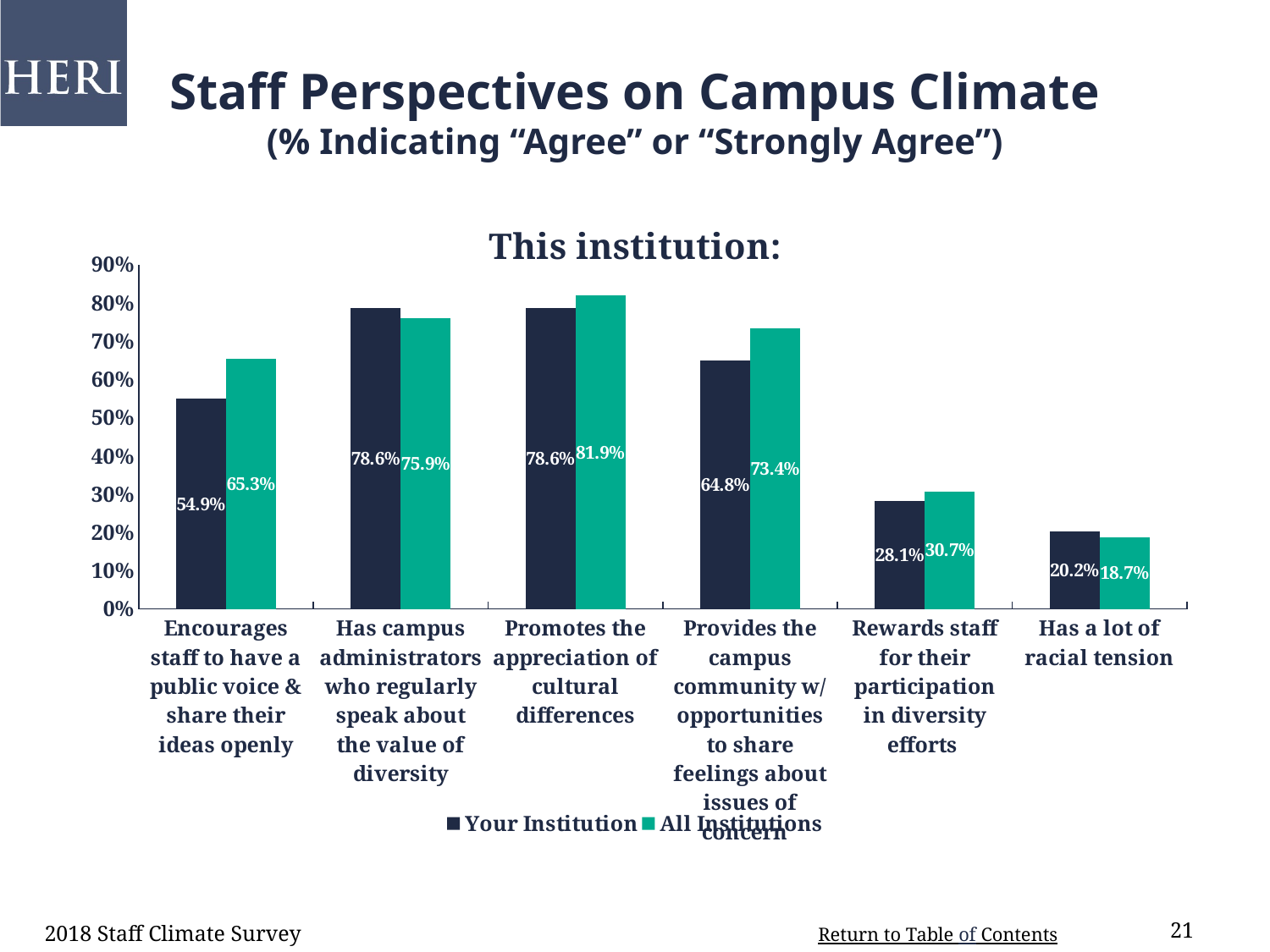
For "Has campus administrators who regularly speak about the value of diversity", which is larger: Your Institution or All Institutions? Your Institution What kind of chart is shown on the slide? bar chart How many categories are shown on the x axis? 6 What is the title of the chart? This institution: What is the value for All Institutions for "Promotes the appreciation of cultural differences"? 81.9% Which category has the lowest value for All Institutions? Has a lot of racial tension What is the difference between All Institutions and Your Institution for "Encourages staff to have a public voice & share their ideas openly"? 10.4% Which category has the highest value for All Institutions? Promotes the appreciation of cultural differences What is the value for Your Institution for "Encourages staff to have a public voice & share their ideas openly"? 54.9% How many series does the legend list? 2 What is the value for Your Institution for "Rewards staff for their participation in diversity efforts"? 28.1% Is the value for Your Institution for "Provides the campus community w/ opportunities to share feelings about issues of concern" greater or less than 60%? greater